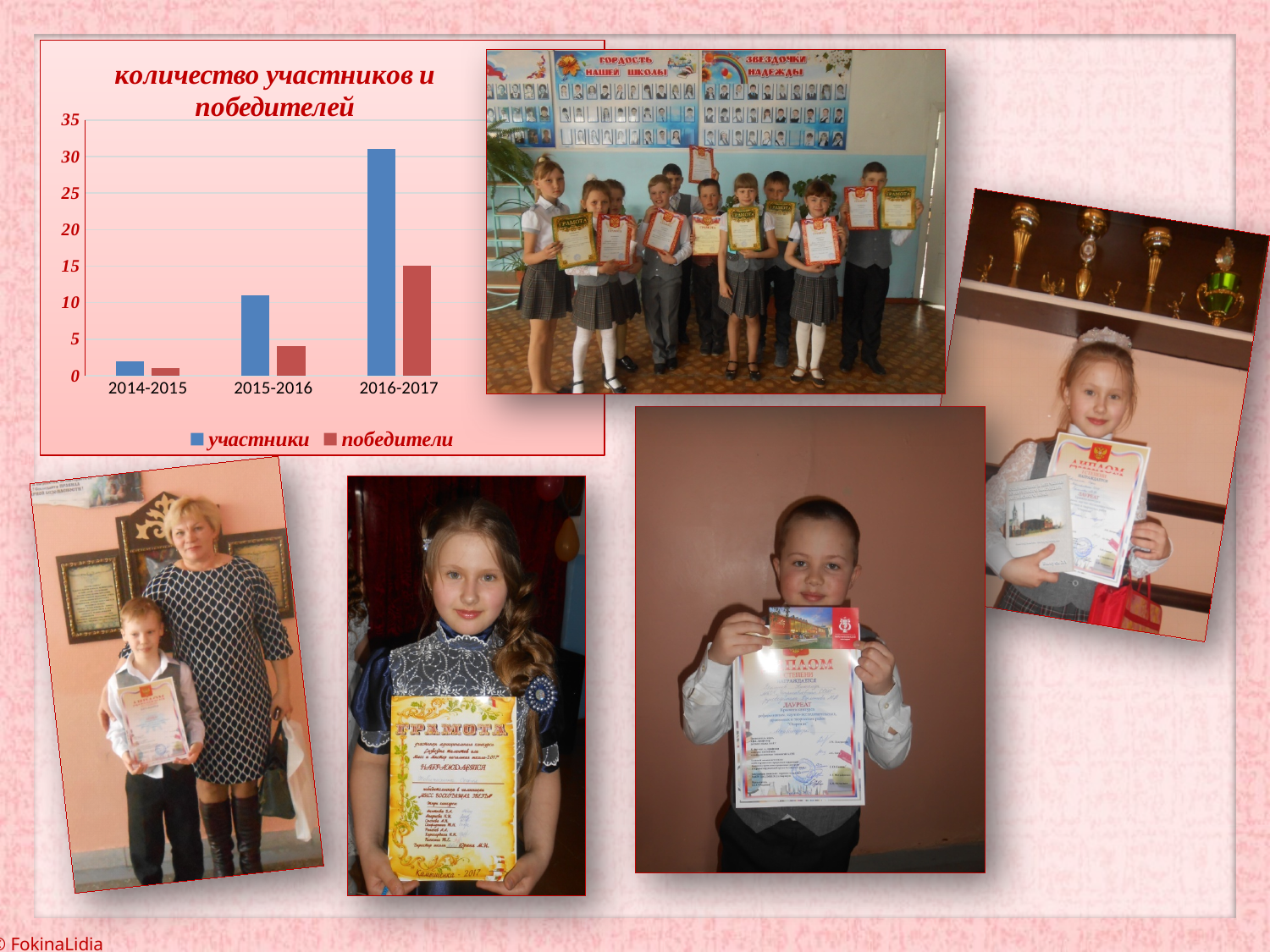
Which is larger in 2016-2017: участники or победители? участники Do the values for участники rise or fall from 2014-2015 to 2016-2017? rise How many categories are shown on the x axis of the chart? 3 How many series does the chart legend list? 2 Which category has the lowest value for победители? 2014-2015 Which colour represents победители in the chart? red What is the title of the chart? количество участников и победителей Which category has the highest value for участники? 2016-2017 Is the value for участники in 2015-2016 greater or less than 10? greater Is the value for участники in 2016-2017 greater or less than 30? greater Is the value for победители in 2015-2016 greater or less than 5? less What kind of chart is shown on the slide? bar chart